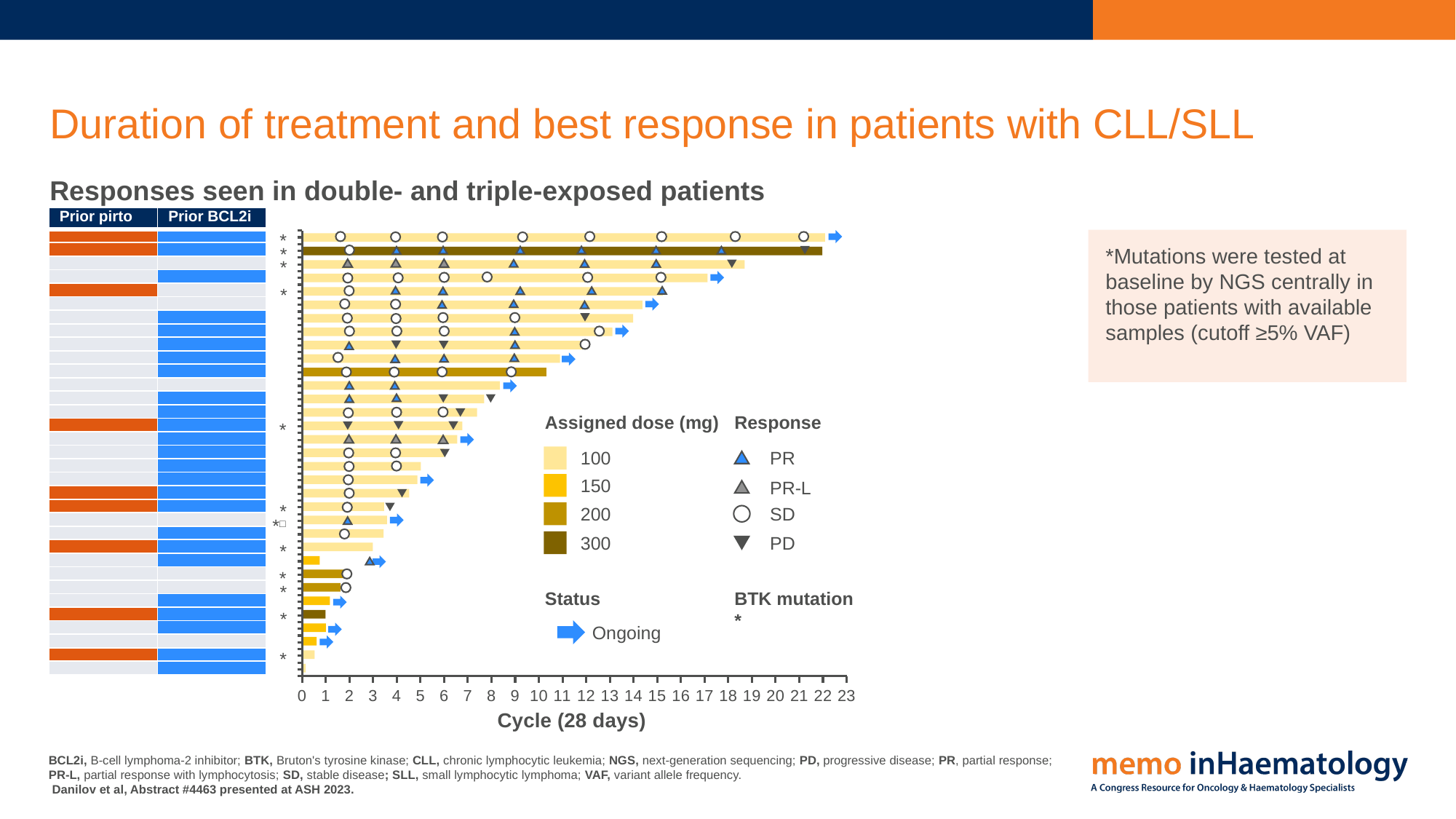
What does the blue arrow at the end of a bar indicate? Ongoing How many assigned dose levels does the legend list? 4 Is the duration of the top bar greater or less than 20 cycles? greater Which assigned dose is represented by the darkest brown bars? 300 What kind of chart is shown on the slide? Bar chart (swimmer plot) What is the highest tick value shown on the x axis? 23 How many response categories does the legend list? 4 Is the duration of the second bar from the top (300 mg) greater or less than 20 cycles? greater What is the label of the x axis? Cycle (28 days) Is the duration of the bottom bar greater or less than 1 cycle? less Going from the top of the chart to the bottom, do the bars get longer or shorter? shorter